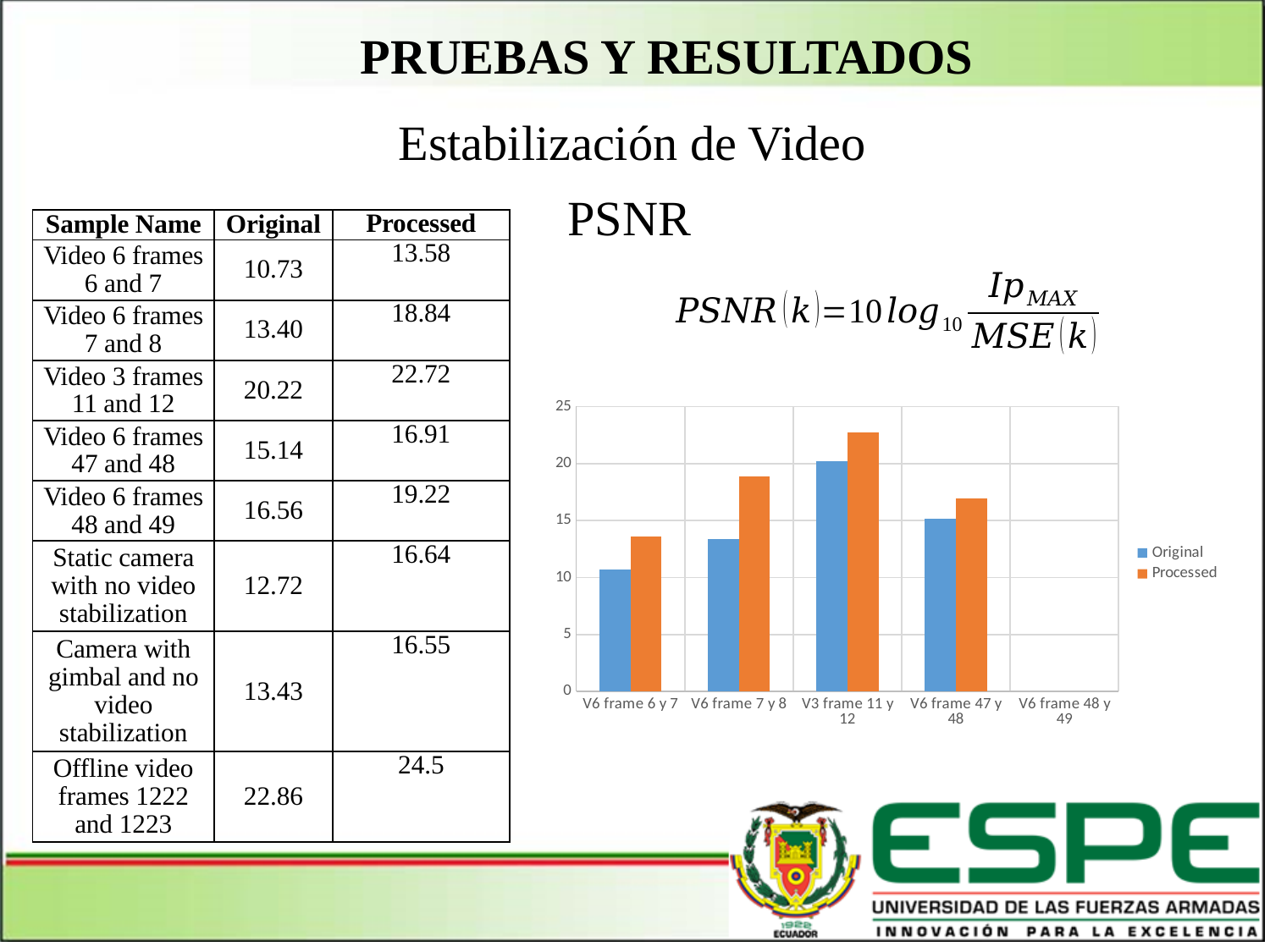
Is the Processed value for V6 frame 47 y 48 greater or less than 15? greater Which category on the x axis has no bars plotted? V6 frame 48 y 49 For which category is the Original bar the shortest? V6 frame 6 y 7 Is the Original value for V6 frame 6 y 7 greater or less than 10? greater Is the Processed value for V3 frame 11 y 12 greater or less than 20? greater What kind of chart is shown on the slide? Bar chart How many category labels appear along the x axis of the chart? 5 For V6 frame 7 y 8, which is larger, the Original bar or the Processed bar? Processed For which category is the Processed bar the tallest? V3 frame 11 y 12 Which series is shown in orange in the chart? Processed How many series does the chart's legend list? 2